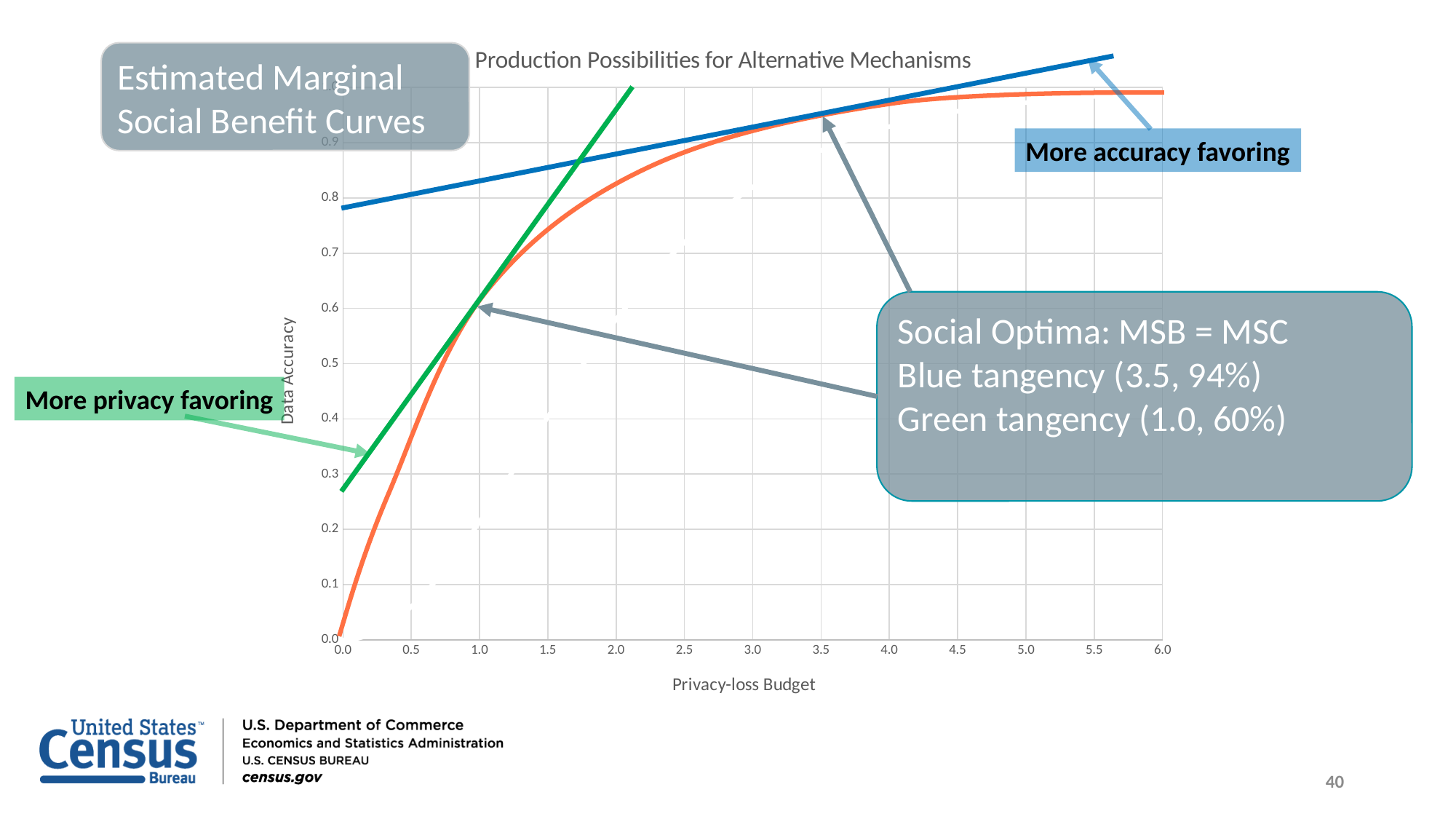
What kind of chart is shown on the slide? line chart According to the annotation, what is the data accuracy at the blue tangency point? 94% What is the difference in data accuracy between the blue tangency (94%) and the green tangency (60%)? 34 percentage points According to the annotation, at what privacy-loss budget does the green tangency occur? 1.0 Is the value of the green line at a privacy-loss budget of 0.0 greater or less than 0.3? less What is the label of the x axis of the chart? Privacy-loss Budget Which tangency point has the higher data accuracy, the blue tangency or the green tangency? blue tangency What is the title of the chart? Production Possibilities for Alternative Mechanisms How many lines are plotted on the chart? 3 Is the data accuracy of the orange curve at a privacy-loss budget of 2.0 greater or less than 0.7? greater Does the orange curve rise or fall as the privacy-loss budget increases? rise According to the annotation, what is the data accuracy at the green tangency point? 60%